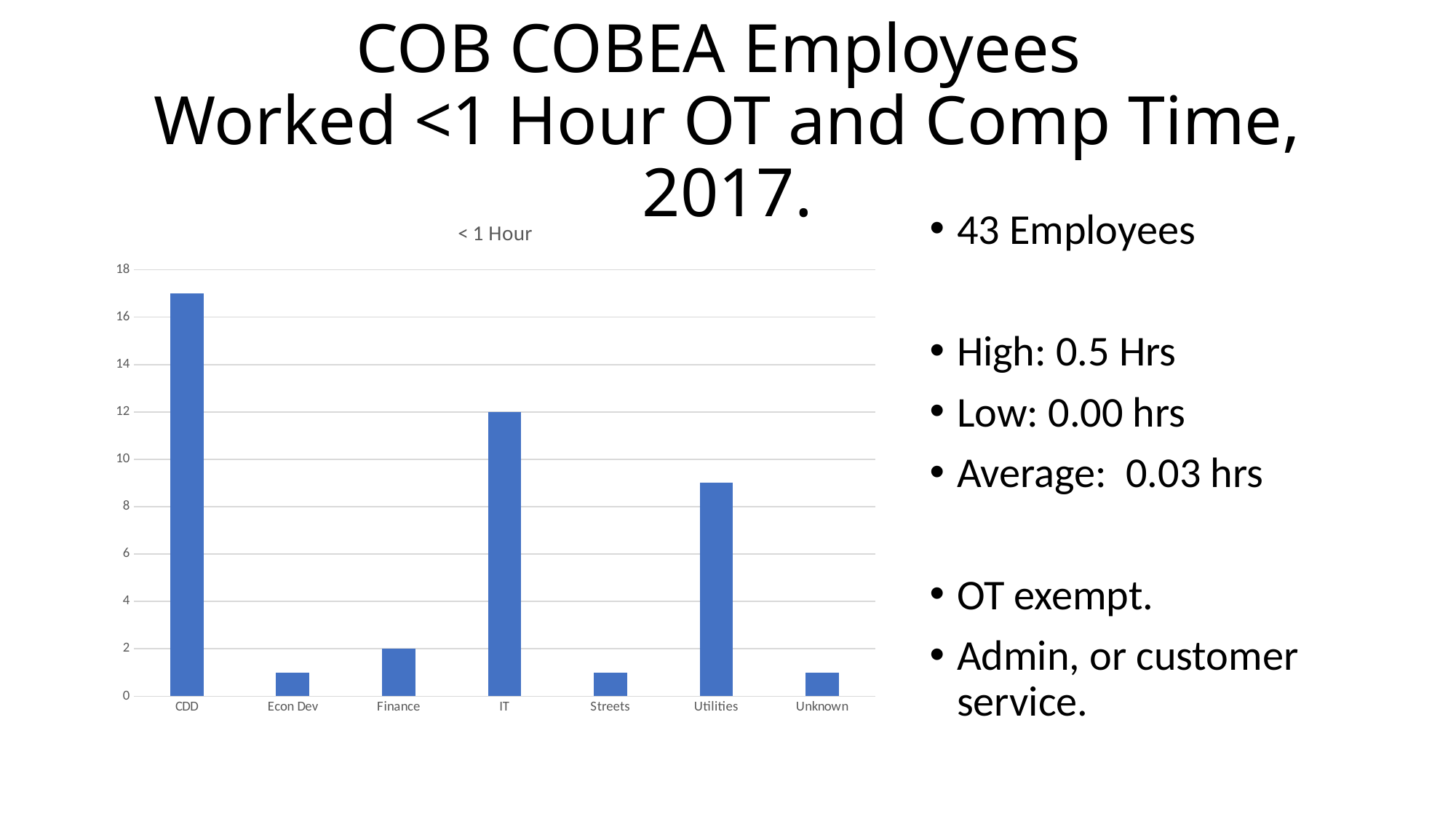
What is the title of the chart? < 1 Hour What is the value for Finance in the chart? 2 How many categories are shown on the x axis of the chart? 7 Which is larger, the value for IT or the value for Utilities? IT Which is larger, the value for Utilities or the value for Finance? Utilities What kind of chart is shown on the slide? bar chart Which category has the highest bar in the chart? CDD Is the value for Utilities greater or less than 10? less Is the value for CDD greater or less than 16? greater What is the value for IT in the chart? 12 Is the value for Econ Dev greater or less than 2? less What is the difference between the values for IT and Finance? 10